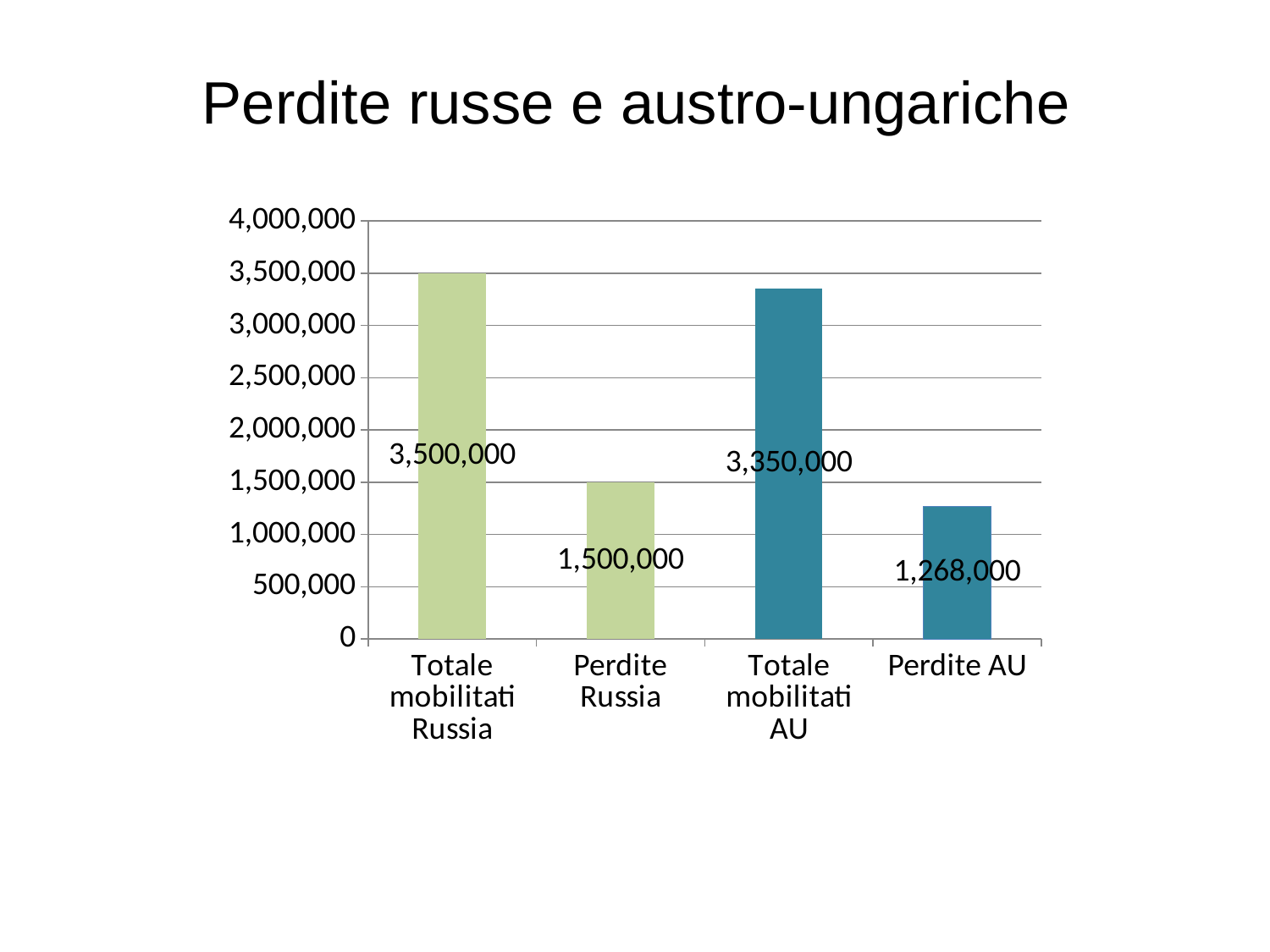
What is the difference between Perdite Russia and Perdite AU? 232,000 What is the title of the slide? Perdite russe e austro-ungariche What is the value for Perdite Russia? 1,500,000 Which category has the highest value? Totale mobilitati Russia What is the difference between Totale mobilitati Russia and Perdite Russia? 2,000,000 What is the value for Totale mobilitati AU? 3,350,000 Which is larger, Totale mobilitati Russia or Totale mobilitati AU? Totale mobilitati Russia What is the value for Totale mobilitati Russia? 3,500,000 What is the value for Perdite AU? 1,268,000 How many categories are shown on the chart? 4 What kind of chart is shown on the slide? Bar chart Which category has the lowest value? Perdite AU